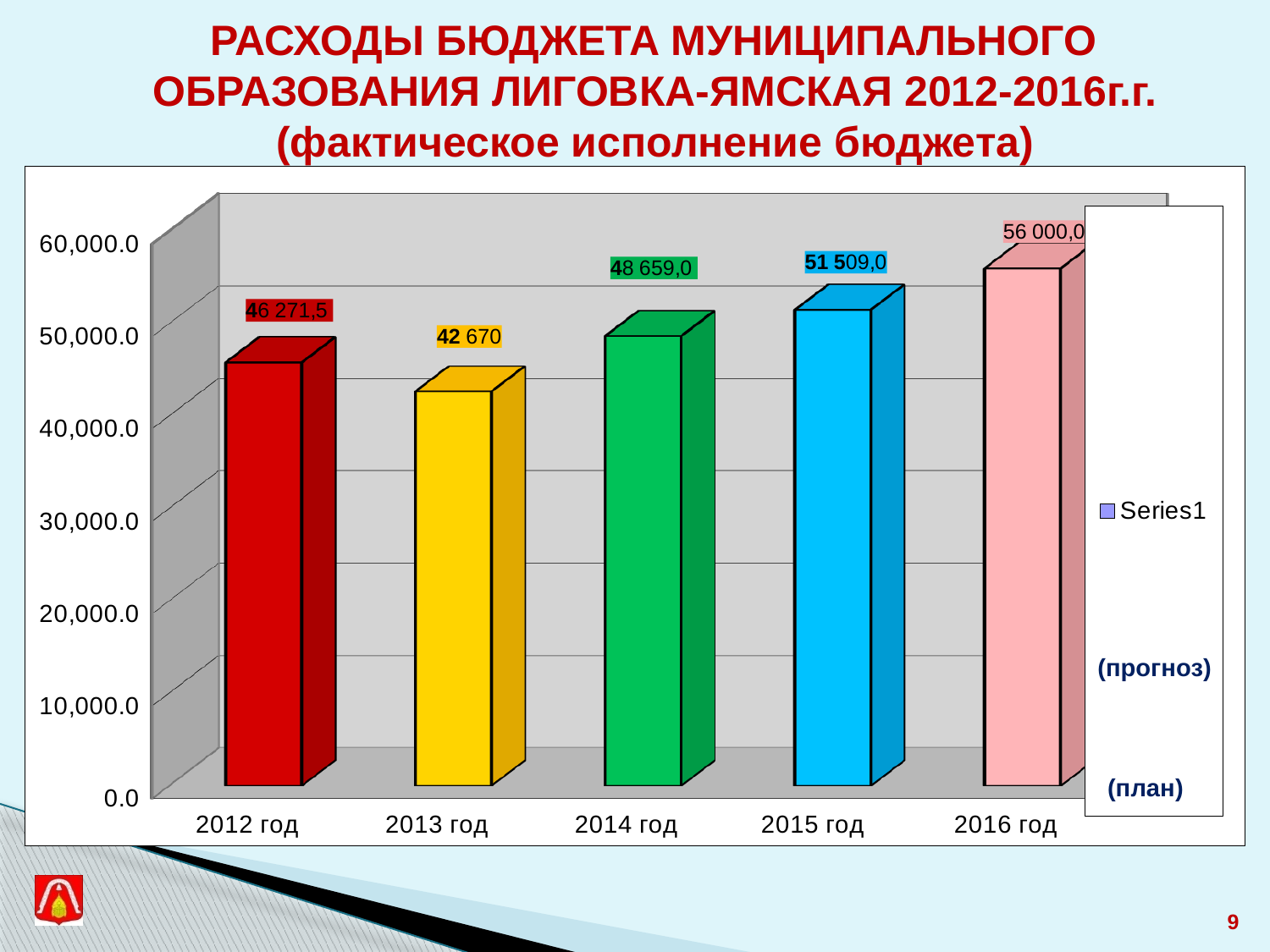
What is the value for 2016 год? 56 000,0 What is the value for 2012 год? 46 271,5 What kind of chart is shown on the slide? bar chart What is the value for 2013 год? 42 670 How many years are shown on the x axis? 5 What is the difference between the values for 2016 год and 2015 год? 4 491,0 Which is larger, the value for 2014 год or the value for 2012 год? 2014 год What series name does the legend list? Series1 Which year has the highest value? 2016 год Which year has the lowest value? 2013 год Is the value for 2013 год greater or less than 40,000.0? greater What is the value for 2015 год? 51 509,0